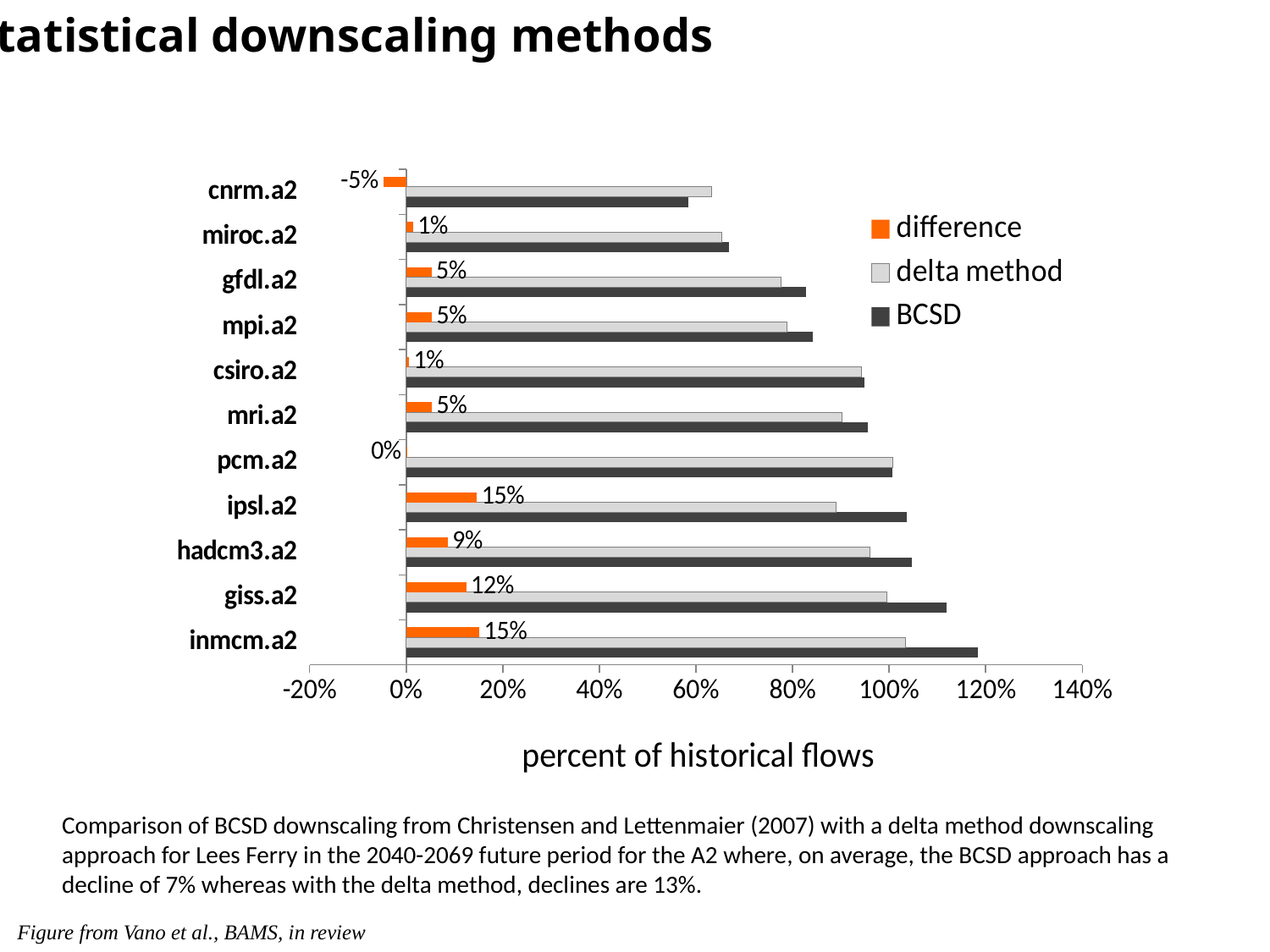
Which has the larger difference value, giss.a2 or hadcm3.a2? giss.a2 What is the difference value shown for hadcm3.a2? 9% What is the difference value shown for ipsl.a2? 15% What is the title of the horizontal axis? percent of historical flows How many series does the legend list? 3 Which model has the lowest difference value? cnrm.a2 Is the delta method value for cnrm.a2 greater or less than 80%? less By how many percentage points does the difference for ipsl.a2 exceed the difference for hadcm3.a2? 6 percentage points Is the BCSD value for inmcm.a2 greater or less than 100%? greater What is the difference value shown for cnrm.a2? -5% What is the difference value shown for pcm.a2? 0% How many models (categories) are shown on the chart? 11